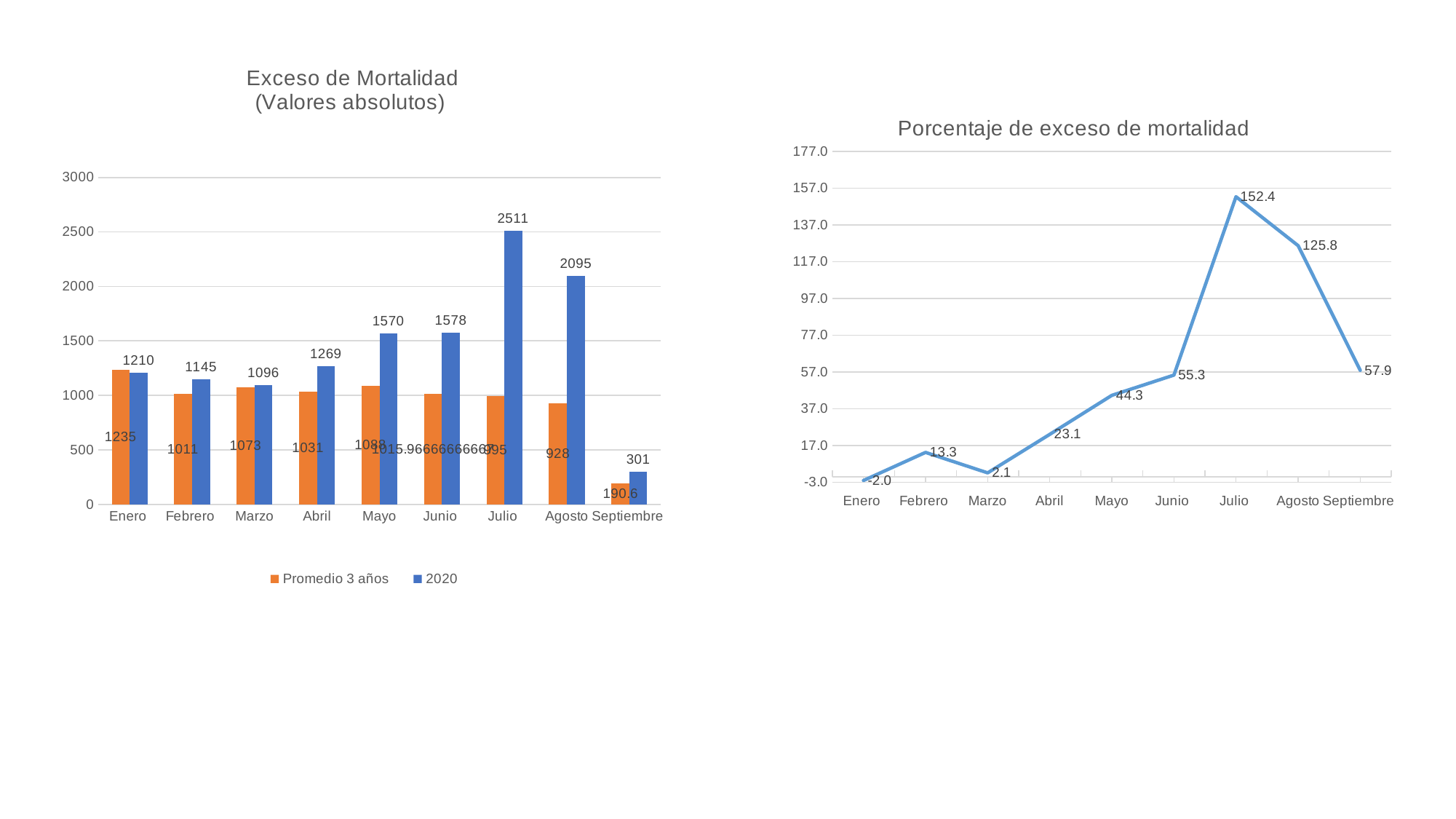
How many months are plotted in the chart 'Porcentaje de exceso de mortalidad'? 9 In the chart 'Exceso de Mortalidad (Valores absolutos)', what is the difference between the 2020 value and the 'Promedio 3 años' value for Agosto? 1167 In the chart 'Exceso de Mortalidad (Valores absolutos)', what is the 2020 value for Julio? 2511 In the chart 'Exceso de Mortalidad (Valores absolutos)', which month has the highest 2020 value? Julio In the chart 'Exceso de Mortalidad (Valores absolutos)', which is larger for Enero: the 'Promedio 3 años' value or the 2020 value? Promedio 3 años How many series does the legend of the chart 'Exceso de Mortalidad (Valores absolutos)' list? 2 In the chart 'Exceso de Mortalidad (Valores absolutos)', which month has the lowest 2020 value? Septiembre What kind of chart is 'Porcentaje de exceso de mortalidad'? Line chart In the chart 'Porcentaje de exceso de mortalidad', what is the value for Julio? 152.4 In the chart 'Exceso de Mortalidad (Valores absolutos)', what is the 'Promedio 3 años' value for Enero? 1235 In the chart 'Porcentaje de exceso de mortalidad', which month has the lowest value? Enero In the chart 'Porcentaje de exceso de mortalidad', do the values rise or fall from Julio to Septiembre? Fall